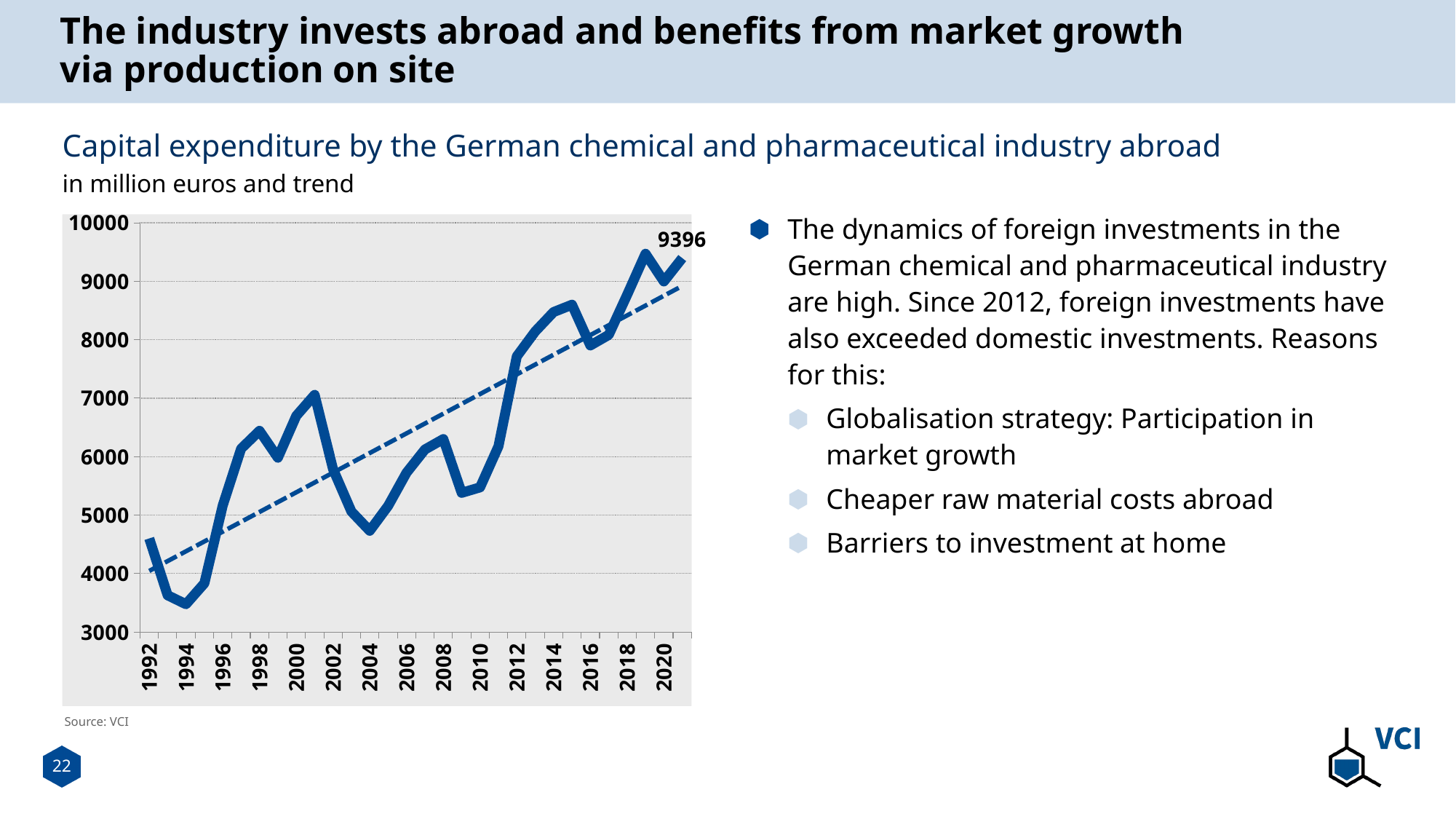
Which year has the higher value, 1998 or 2004? 1998 What type of chart is shown on the slide? line chart Is the value for 2012 greater or less than 7000? greater What is the title of the chart? Capital expenditure by the German chemical and pharmaceutical industry abroad Is the value for 1994 greater or less than 4000? less Does the overall trend of capital expenditure abroad rise or fall from 1992 to the end of the series? rise Around which year does the line reach its lowest value? 1994 What value is printed at the end of the line in the chart? 9396 Is the value for 2004 greater or less than 5000? less In what unit are the values in the chart given? million euros How many year labels are shown on the x axis of the chart? 15